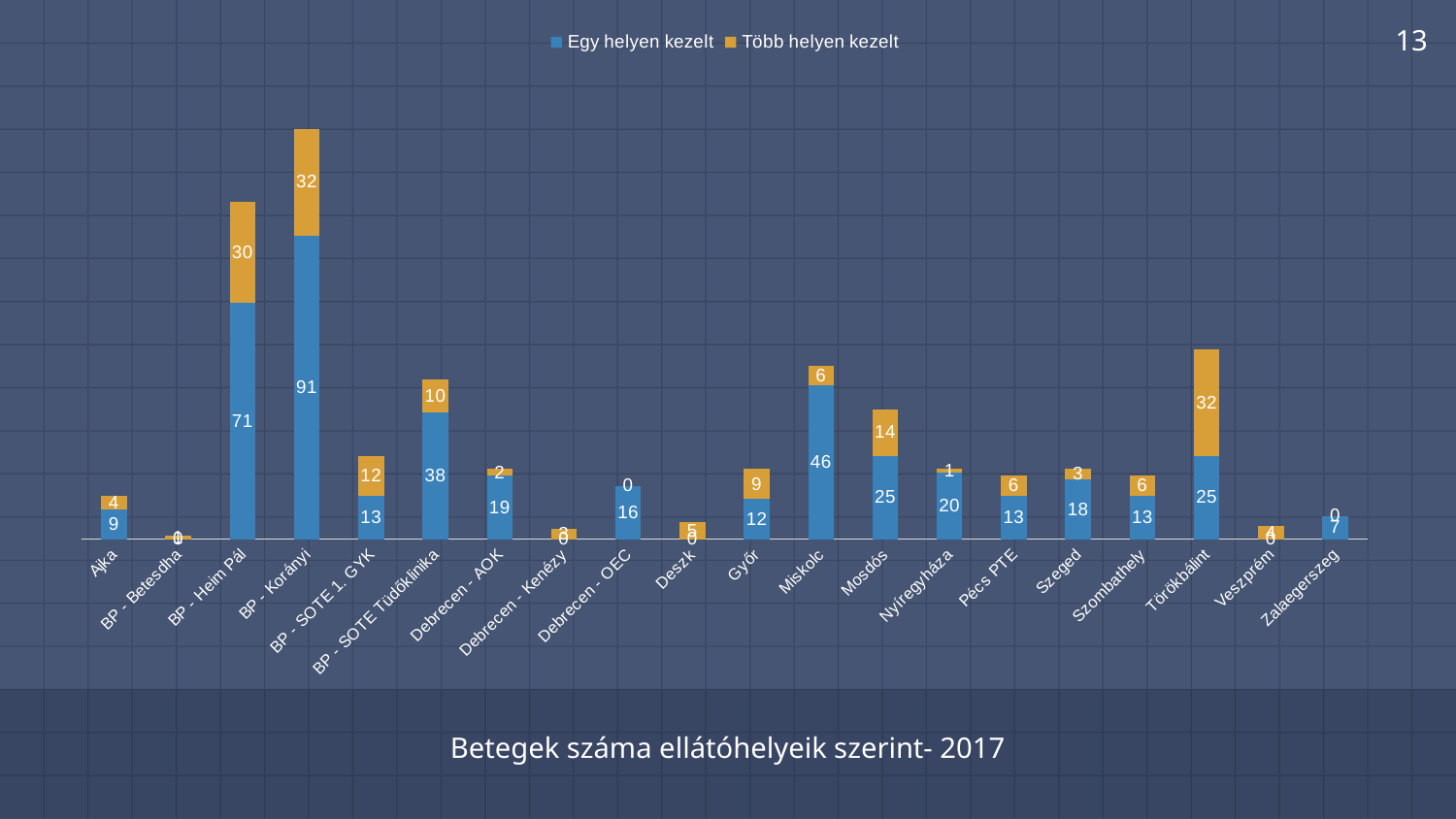
Which category has the highest 'Egy helyen kezelt' value? BP - Korányi What is the 'Egy helyen kezelt' value for Miskolc? 46 What is the difference between the 'Egy helyen kezelt' values for BP - Korányi and BP - Heim Pál? 20 What is the 'Egy helyen kezelt' value for BP - Korányi? 91 What is the title of the chart? Betegek száma ellátóhelyeik szerint- 2017 How many categories are shown on the x axis? 20 What is the 'Több helyen kezelt' value for BP - Heim Pál? 30 What type of chart is shown on the slide? Stacked bar chart What is the total of the stacked bar for Törökbálint? 57 Which is larger: the 'Egy helyen kezelt' value for Mosdós or for Nyíregyháza? Mosdós How many series does the legend list? 2 What is the total of the stacked bar for BP - Heim Pál? 101